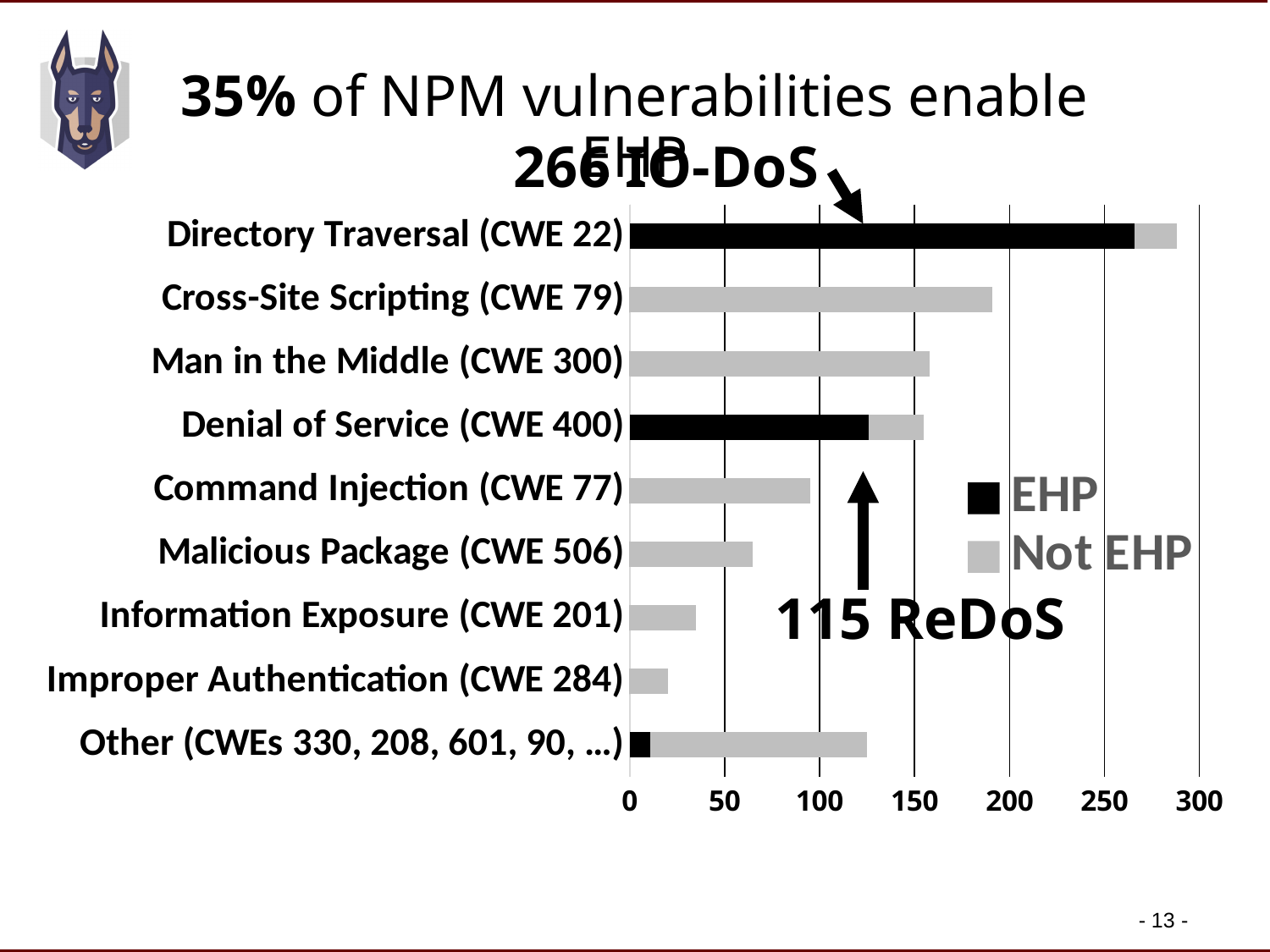
Which colour represents the EHP series in the chart? black How many vulnerability categories are plotted on the chart? 9 According to the annotation, how many ReDoS vulnerabilities are in the EHP portion of Denial of Service (CWE 400)? 115 According to the annotation, how many IO-DoS vulnerabilities are in the EHP portion of Directory Traversal (CWE 22)? 266 Is the total bar for Cross-Site Scripting (CWE 79) greater or less than 150? greater What are the two series named in the legend? EHP and Not EHP Which has a longer total bar, Cross-Site Scripting (CWE 79) or Man in the Middle (CWE 300)? Cross-Site Scripting (CWE 79) Which category has the shortest total bar? Improper Authentication (CWE 284) Is the total bar for Information Exposure (CWE 201) greater or less than 50? less What kind of chart is shown on the slide? bar chart Which category has the longest total bar? Directory Traversal (CWE 22) How many series does the chart's legend list? 2